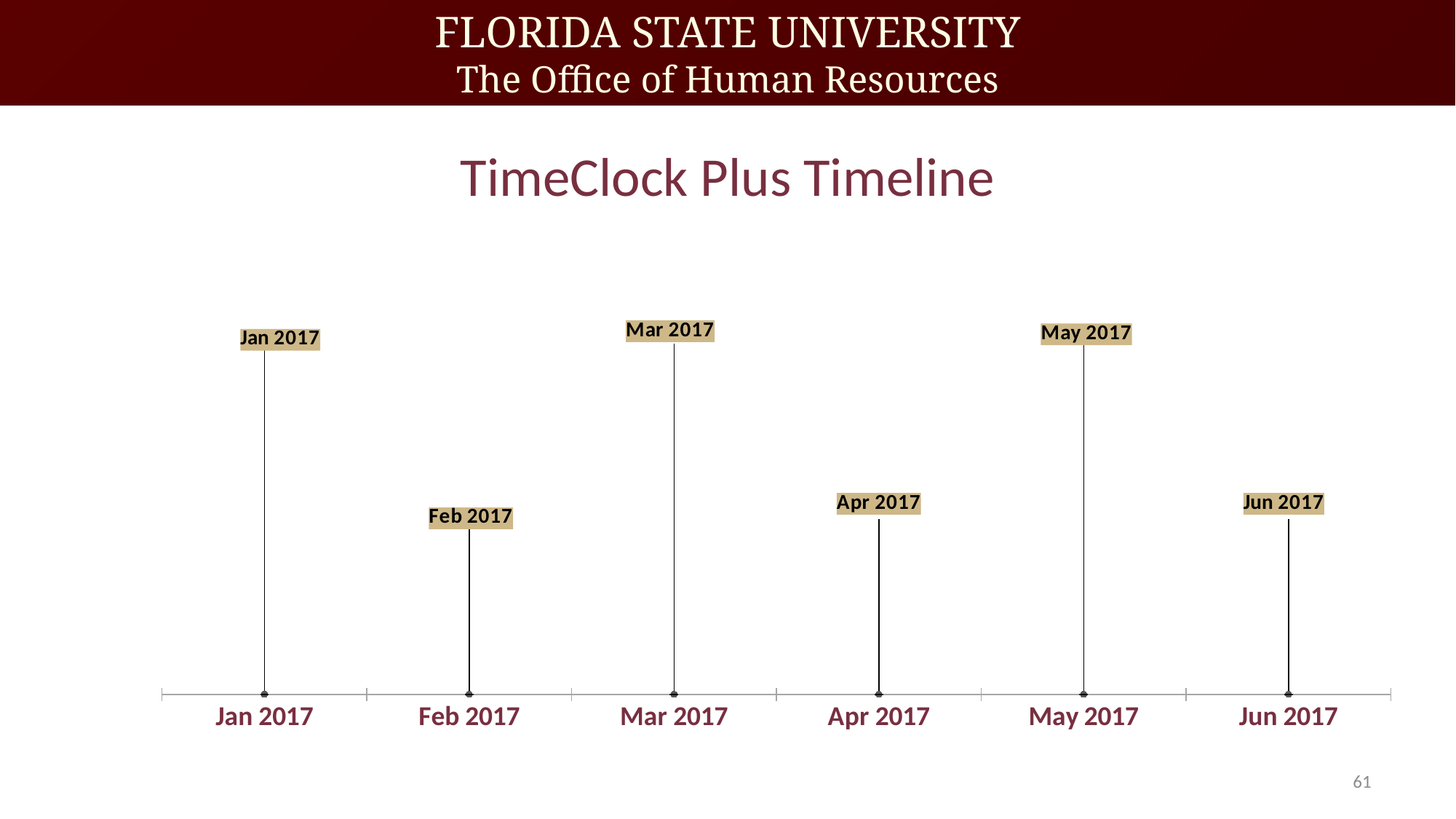
What is the first category on the x axis of the timeline chart? Jan 2017 What kind of chart is shown on the slide? timeline How many points are marked on the timeline chart? 6 What label is shown at the top of the line for the fourth point on the timeline chart? Apr 2017 What is the last category on the x axis of the timeline chart? Jun 2017 What is the title of the chart on the slide? TimeClock Plus Timeline Which year do all the points on the timeline chart belong to? 2017 Which category comes immediately after Mar 2017 on the timeline chart? Apr 2017